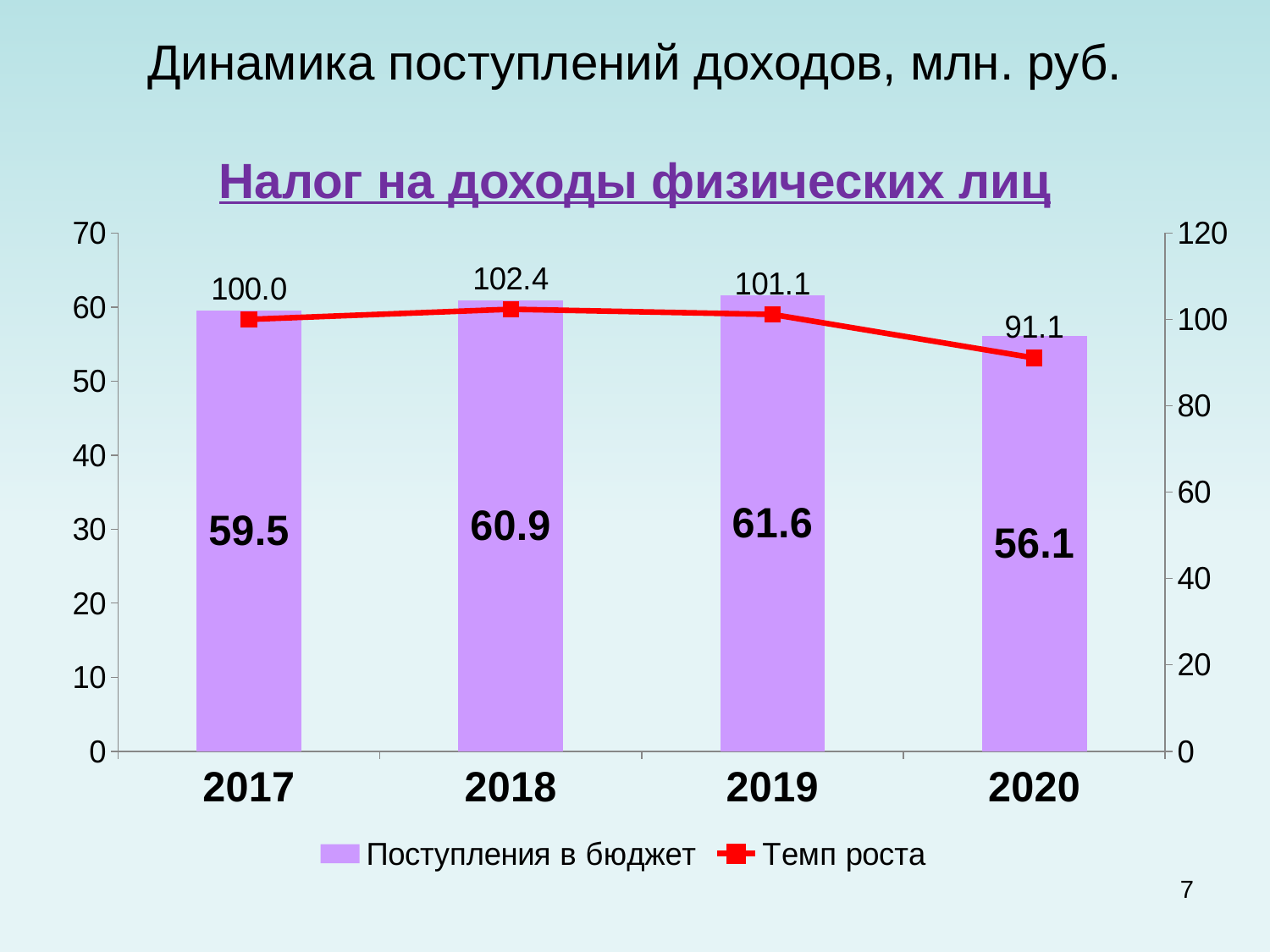
What is the value of Поступления в бюджет for 2019? 61.6 What kind of chart is used for the Поступления в бюджет series? bar chart How many years are shown on the x axis? 4 How many series does the legend list? 2 Which year has the lowest Темп роста value? 2020 Which is larger, the Поступления в бюджет value for 2017 or for 2018? 2018 Does the Темп роста line rise or fall from 2019 to 2020? fall Which year has the highest Поступления в бюджет value? 2019 What is the Темп роста value for 2018? 102.4 What is the difference between the Поступления в бюджет values for 2019 and 2020? 5.5 What is the value of Поступления в бюджет for 2020? 56.1 What is the title of the chart? Налог на доходы физических лиц